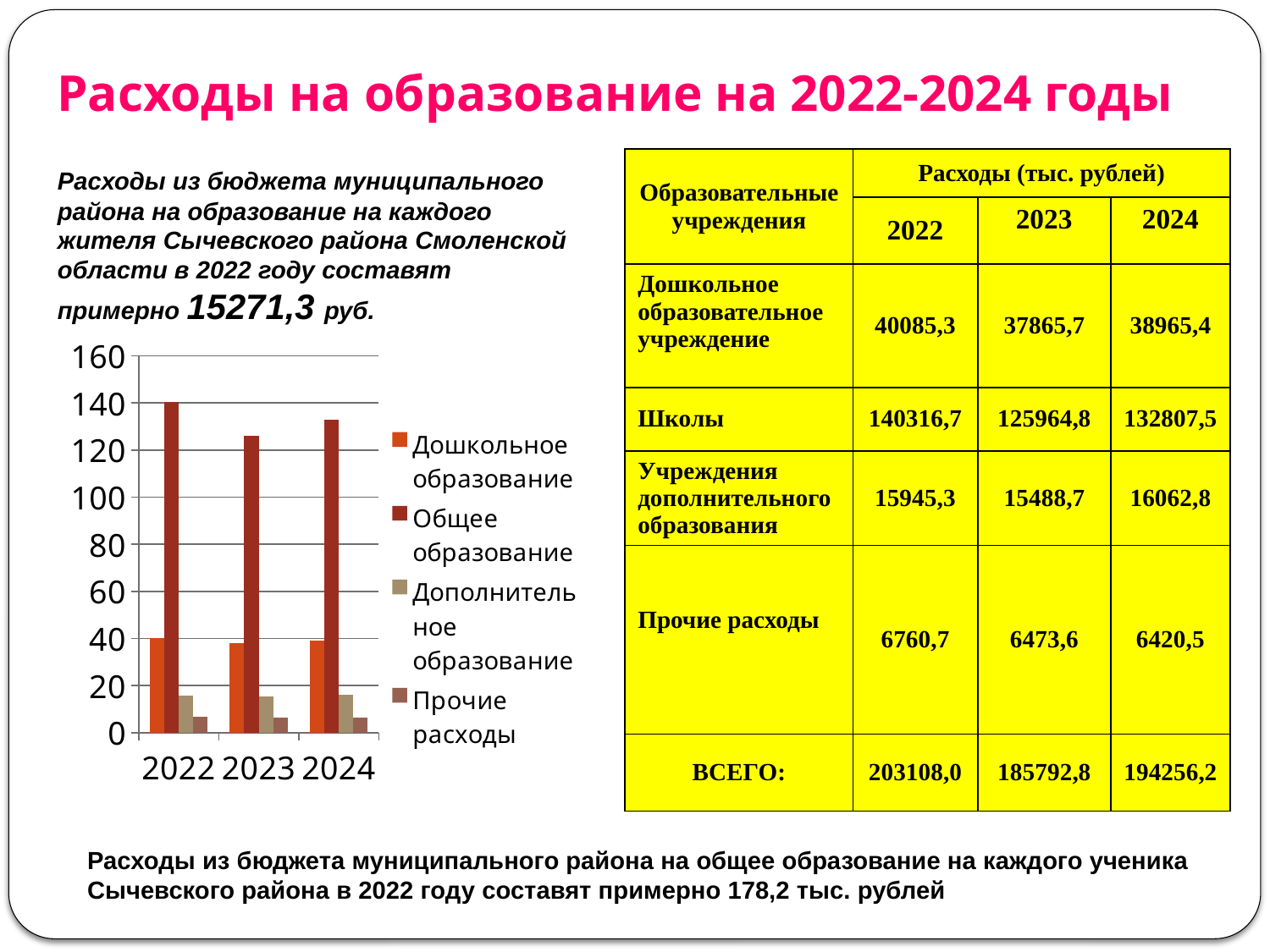
Is the value for Общее образование in 2024 greater or less than 120? greater How many year categories are shown on the x axis of the chart? 3 Which legend entry is shown in dark red in the chart? Общее образование How many series does the chart legend list? 4 For the series Общее образование, which year has the lowest bar? 2023 Is the value for Дополнительное образование in 2022 greater or less than 20? less Which series has the shortest bar in 2024? Прочие расходы For the series Общее образование, which year has the highest bar? 2022 What kind of chart is shown on the slide? bar chart Is the value for Общее образование in 2023 greater or less than 140? less Which series has the tallest bar in 2022? Общее образование Which is larger in 2023: the bar for Дошкольное образование or the bar for Прочие расходы? Дошкольное образование